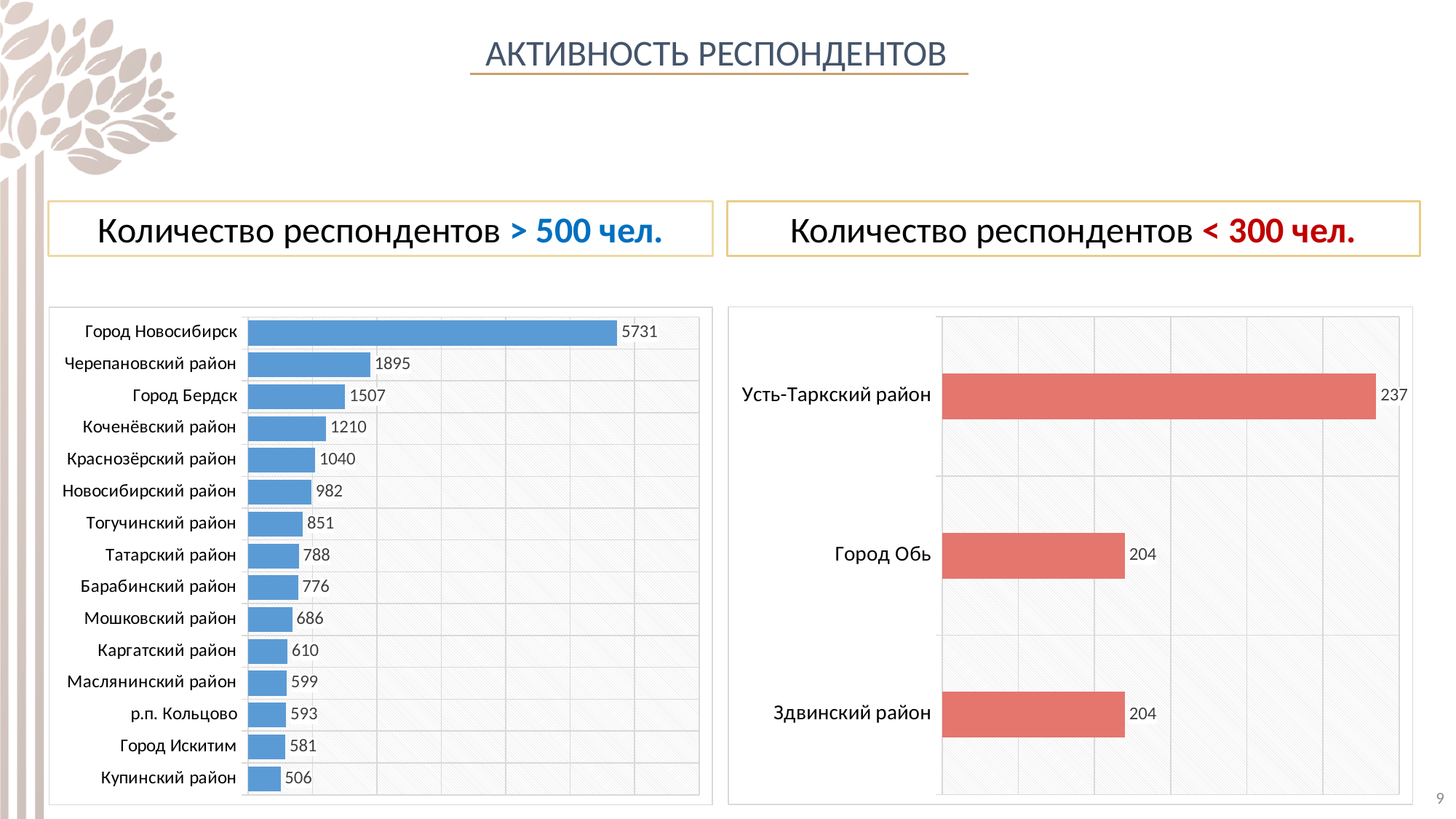
In the left chart (Количество респондентов > 500 чел.), which is larger: Тогучинский район or Мошковский район? Тогучинский район In the right chart (Количество респондентов < 300 чел.), what is the difference between Усть-Таркский район and Здвинский район? 33 What type of chart is the left chart (Количество респондентов > 500 чел.)? Bar chart In the left chart (Количество респондентов > 500 чел.), which category has the lowest value? Купинский район In the left chart (Количество респондентов > 500 чел.), what is the value for Город Новосибирск? 5731 In the left chart (Количество респондентов > 500 чел.), what is the value for Коченёвский район? 1210 In the right chart (Количество респондентов < 300 чел.), which category has the highest value? Усть-Таркский район In the right chart (Количество респондентов < 300 чел.), what is the value for Город Обь? 204 In the left chart (Количество респондентов > 500 чел.), what is the difference between Черепановский район and Город Бердск? 388 In the right chart (Количество респондентов < 300 чел.), what is the value for Усть-Таркский район? 237 In the right chart (Количество респондентов < 300 чел.), how many categories are shown? 3 In the left chart (Количество респондентов > 500 чел.), how many categories are shown? 15